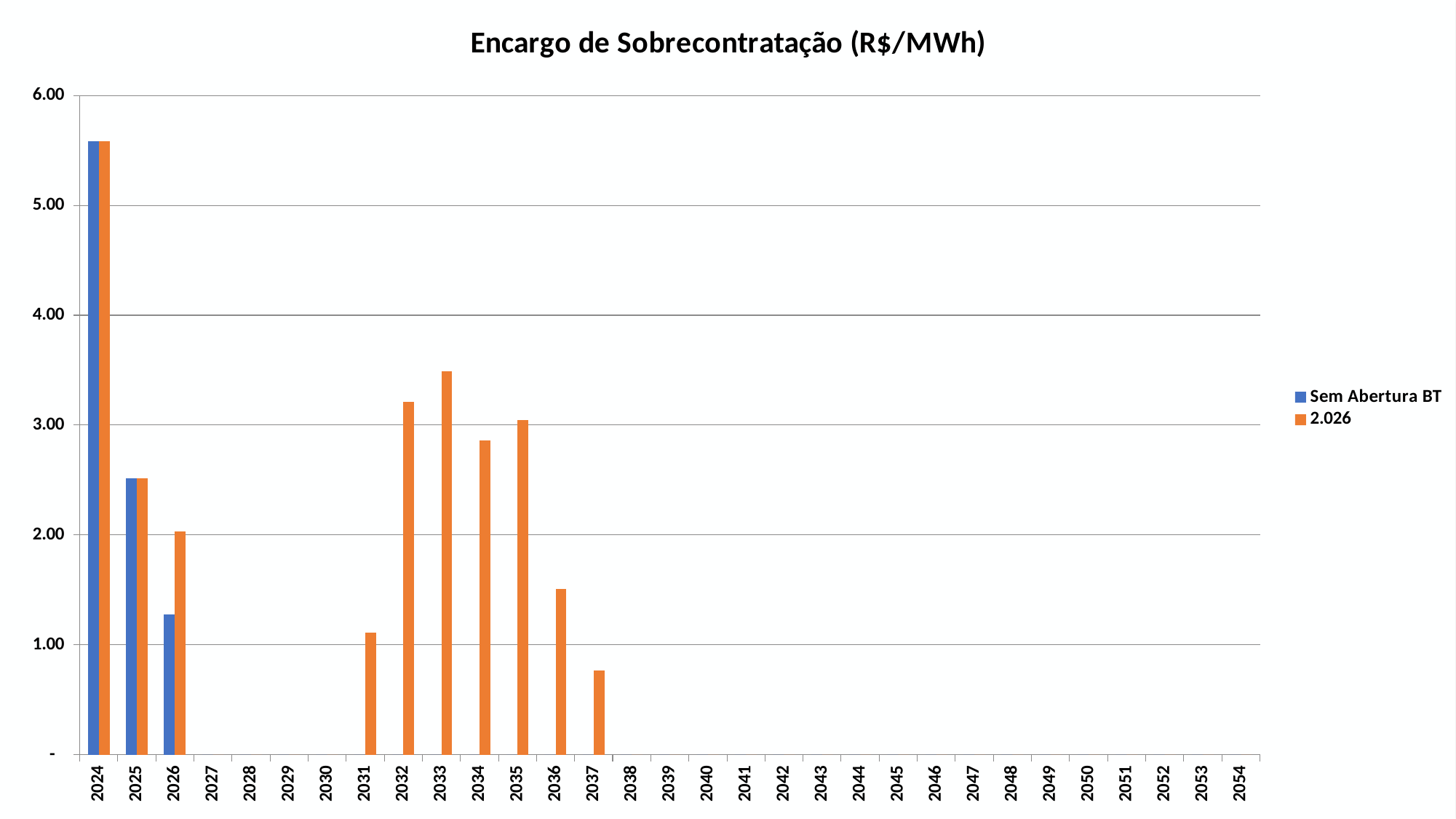
Is the value for the 2.026 series in 2024 greater or less than 5.00? greater What is the title of the chart? Encargo de Sobrecontratação (R$/MWh) How many years are shown on the x axis? 31 Is the value for the 2.026 series in 2033 greater or less than 3.00? greater In which year is the value for the Sem Abertura BT series highest? 2024 Is the value for the 2.026 series in 2037 greater or less than 1.00? less In 2026, which series has the larger value, Sem Abertura BT or 2.026? 2.026 What kind of chart is shown on the slide? bar chart In which year is the value for the 2.026 series highest? 2024 What are the two series named in the legend? Sem Abertura BT and 2.026 How many series does the legend list? 2 For the 2.026 series, which year has the larger value, 2032 or 2033? 2033